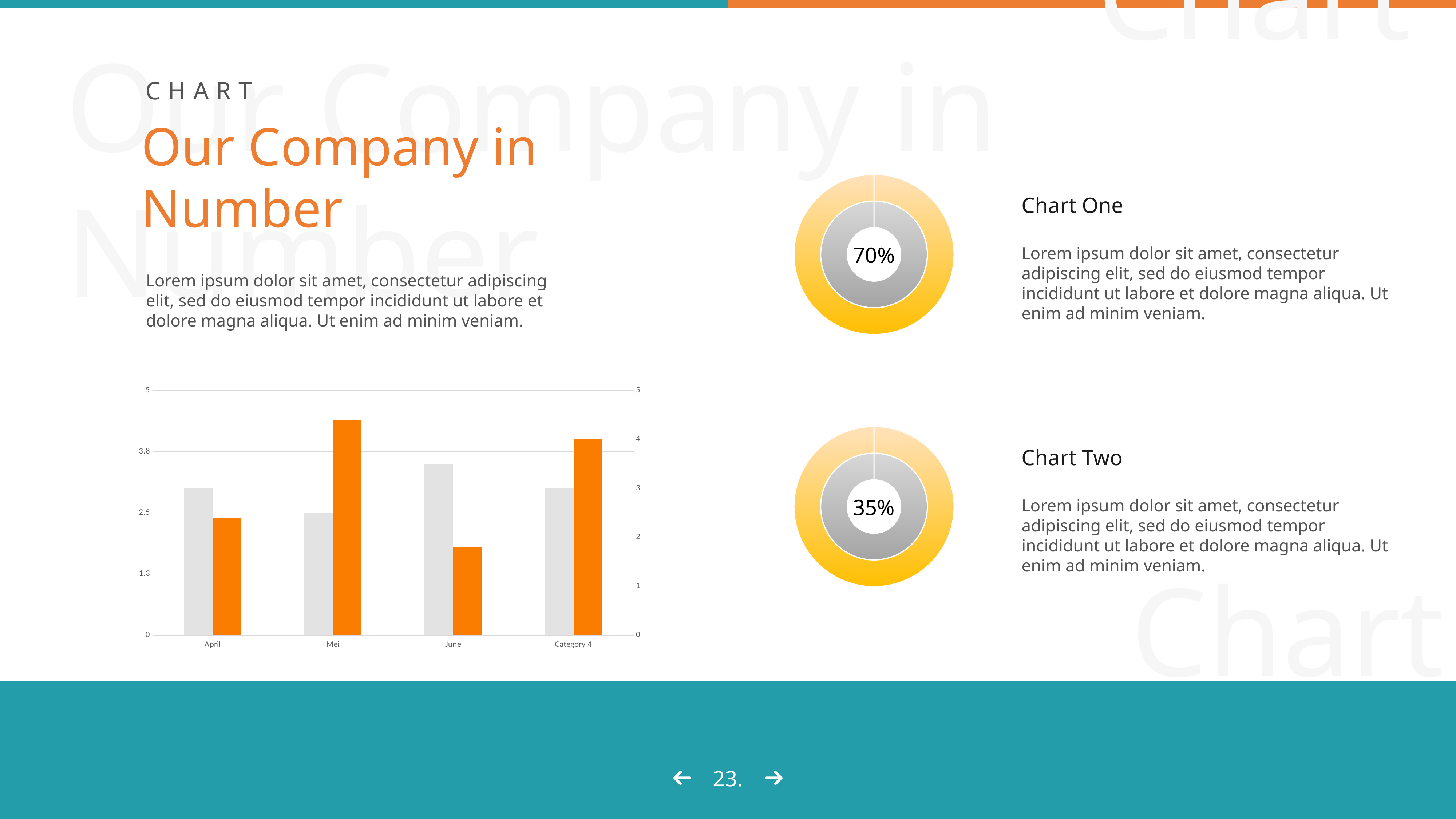
What kind of chart is the chart on the left of the slide with categories April, Mei, June and Category 4? bar chart In the bar chart, which bar is taller for June, the grey bar or the orange bar? the grey bar In the bar chart, which category has the shortest orange bar? June How many categories are shown on the x axis of the bar chart? 4 In the bar chart, is the orange bar for Mei greater or less than 3.8? greater In the bar chart, which category has the tallest orange bar? Mei In the bar chart, is the grey bar for June greater or less than 2.5? greater In the bar chart, is the orange bar for June greater or less than 2.5? less What percentage is shown in the donut chart labelled Chart Two? 35% What percentage is shown in the donut chart labelled Chart One? 70% In the bar chart, which bar is taller for Mei, the grey bar or the orange bar? the orange bar What is the difference between the percentages shown in Chart One and Chart Two? 35%